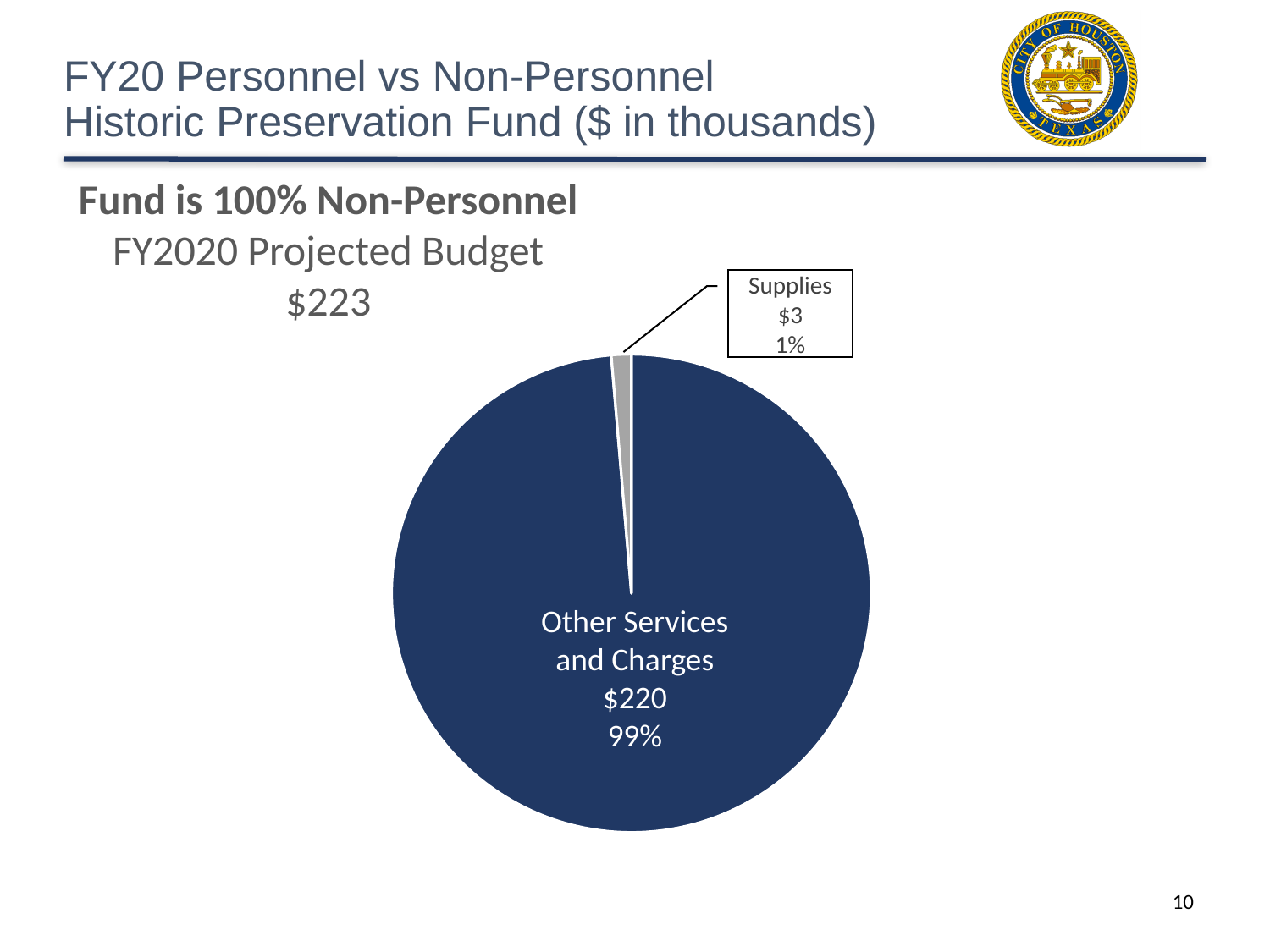
What kind of chart is shown on the slide? pie chart What is the total FY2020 Projected Budget shown on the slide? $223 What is the value for Other Services and Charges? $220 What share of the pie does Other Services and Charges represent? 99% What is the value for Supplies? $3 Which is larger, Supplies or Other Services and Charges? Other Services and Charges Which slice is the smallest? Supplies What is the difference between Other Services and Charges and Supplies? $217 What share of the pie does Supplies represent? 1% What colour is the Supplies slice? grey Which slice is the largest? Other Services and Charges How many slices does the pie chart have? 2